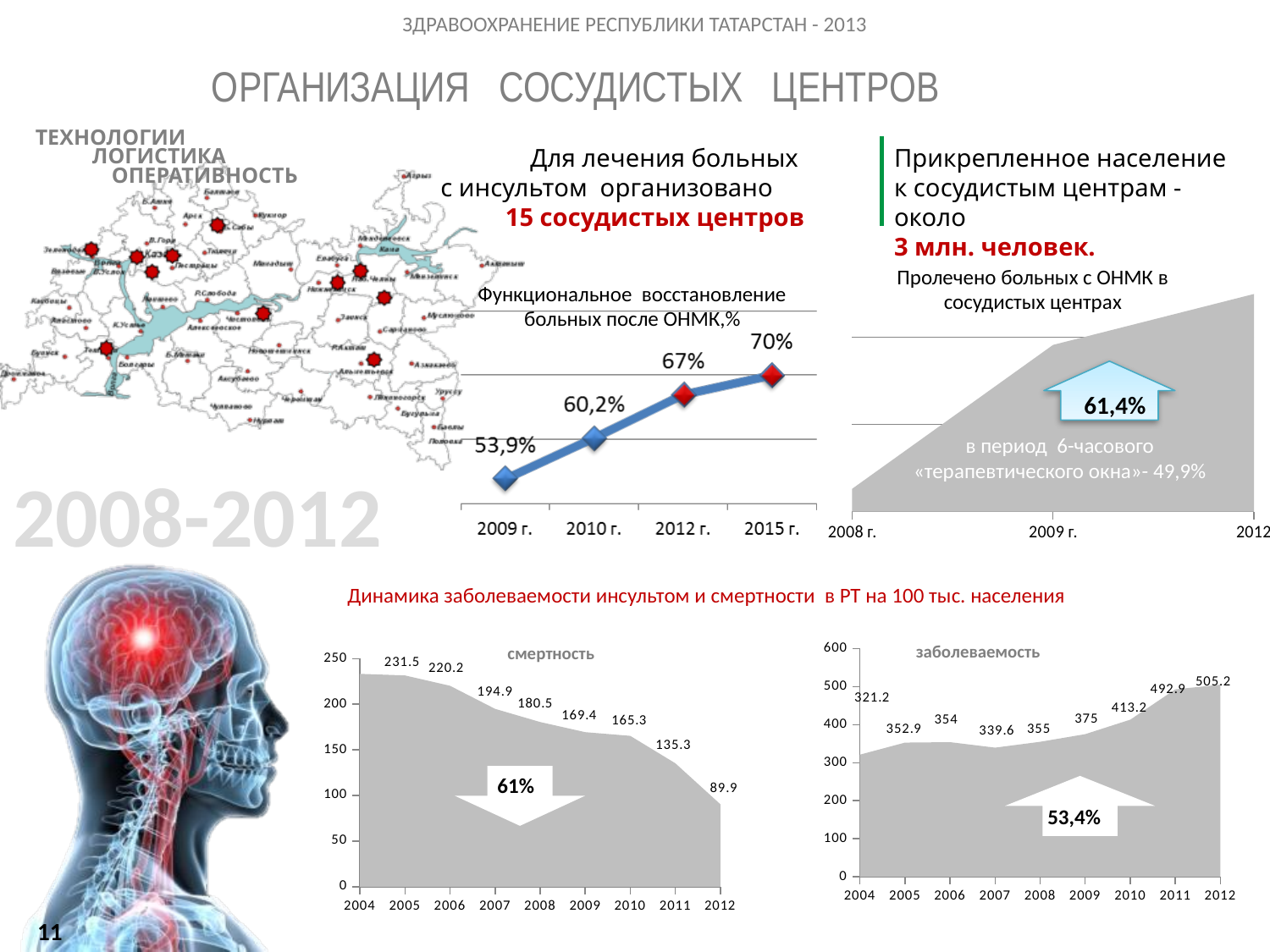
In the chart 'Функциональное восстановление больных после ОНМК,%', do the values rise or fall from 2009 г. to 2015 г.? rise In the 'заболеваемость' chart, which year has the highest value? 2012 In the 'заболеваемость' chart, what is the value for 2012? 505.2 In the chart 'Функциональное восстановление больных после ОНМК,%', what is the value for 2009 г.? 53,9% In the 'смертность' chart, which year has the lowest value? 2012 In the 'смертность' chart, what is the value for 2012? 89.9 In the 'заболеваемость' chart, is the value for 2004 greater or less than 400? less In the chart 'Функциональное восстановление больных после ОНМК,%', what is the value for 2015 г.? 70% In the 'заболеваемость' chart, which is larger: the value for 2007 or the value for 2009? 2009 How many data points are plotted in the chart 'Функциональное восстановление больных после ОНМК,%'? 4